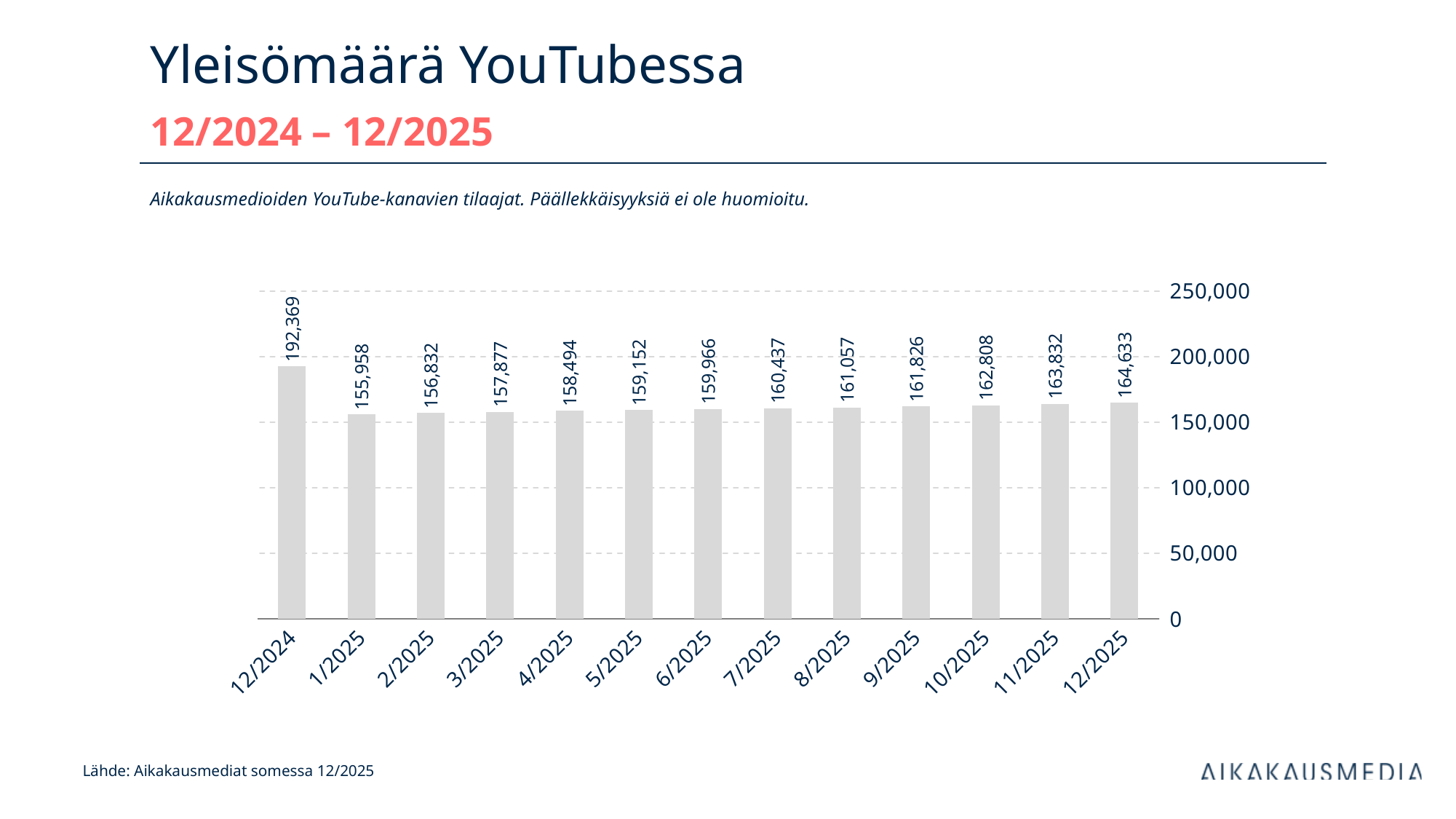
From 1/2025 to 12/2025, do the values rise or fall? Rise Which month has the lowest value? 1/2025 How many months are shown on the x axis? 13 What is the value for 6/2025? 159,966 What kind of chart is shown on the slide? Bar chart What is the difference between the values for 12/2024 and 12/2025? 27,736 Which is larger, the value for 3/2025 or the value for 9/2025? 9/2025 Which month has the highest value? 12/2024 What is the difference between the values for 12/2025 and 1/2025? 8,675 Is the value for 12/2024 greater or less than 150,000? greater What is the value for 12/2025? 164,633 What is the value for 12/2024? 192,369